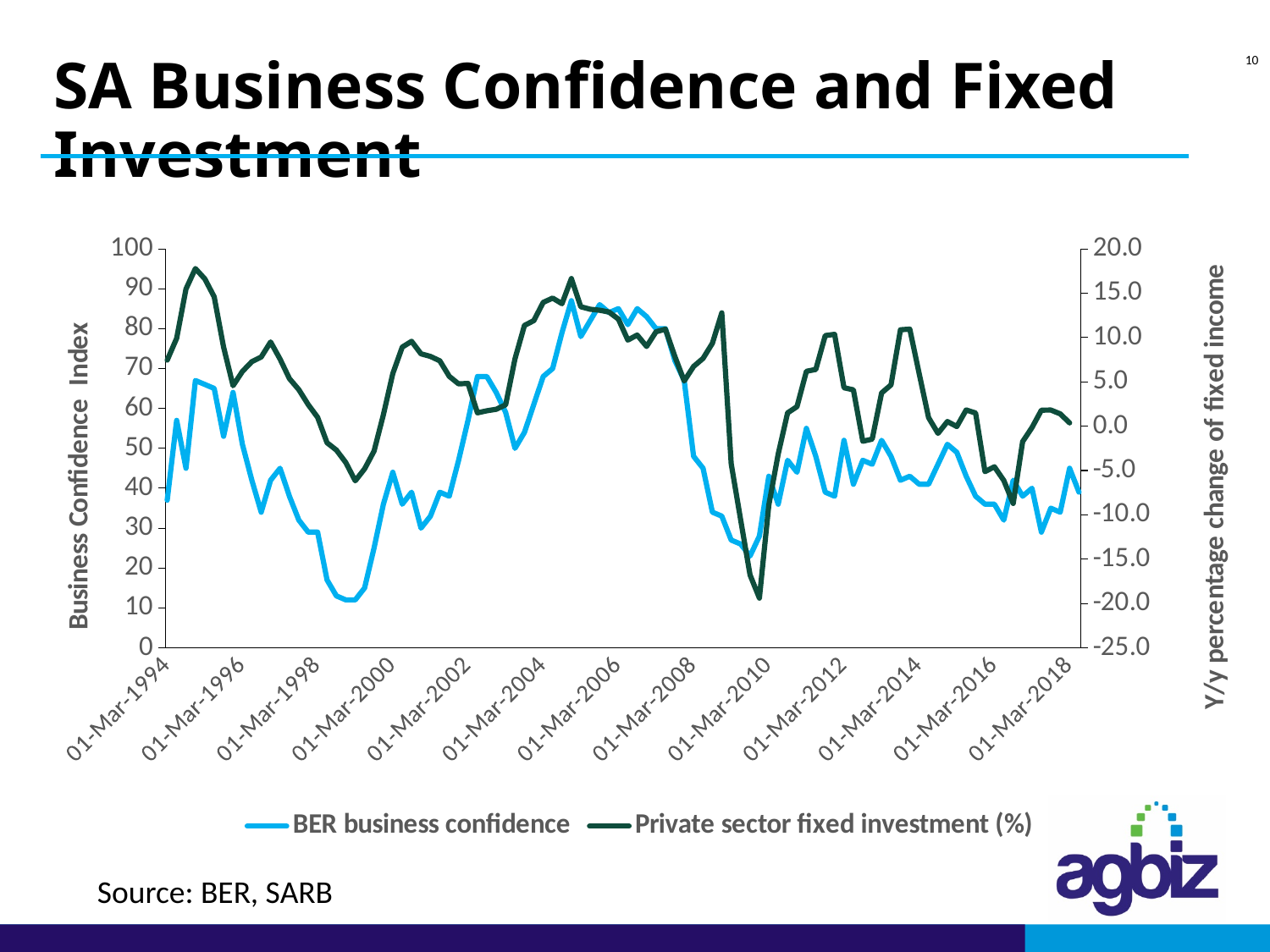
Is the value for BER business confidence at 01-Mar-2006 greater or less than 80? greater How many date labels are shown on the x axis? 13 What are the two series named in the legend? BER business confidence; Private sector fixed investment (%) How many series does the legend list? 2 What kind of chart is shown on the slide? line chart Does the BER business confidence series rise or fall between 01-Mar-2008 and 01-Mar-2010? fall Around which x-axis label does the Private sector fixed investment (%) series reach its lowest point? 01-Mar-2010 Is the value for BER business confidence at 01-Mar-2000 greater or less than 20? greater What is the title of the left vertical axis? Business Confidence Index